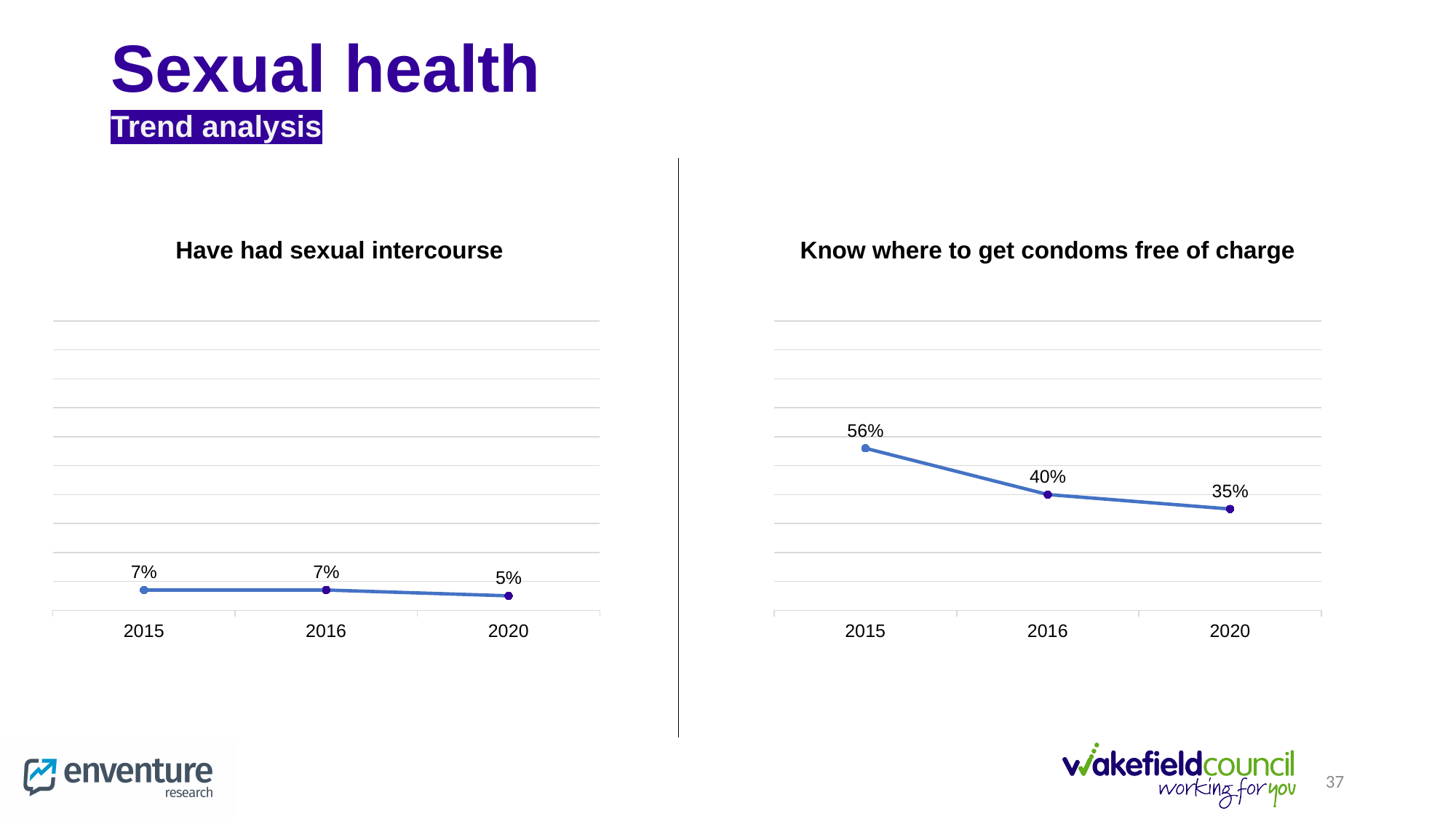
In the 'Know where to get condoms free of charge' chart, do the values rise or fall from 2015 to 2020? fall What type of chart is the 'Know where to get condoms free of charge' chart? line chart In the 'Know where to get condoms free of charge' chart, what is the difference between the 2015 and 2020 values? 21 percentage points In the 'Know where to get condoms free of charge' chart, which year has the lowest value? 2020 In the 'Have had sexual intercourse' chart, what is the value for 2015? 7% In the 'Know where to get condoms free of charge' chart, is the value for 2016 larger or smaller than the value for 2020? larger In the 'Have had sexual intercourse' chart, what is the difference between the 2016 and 2020 values? 2 percentage points In the 'Know where to get condoms free of charge' chart, what is the value for 2016? 40% In the 'Know where to get condoms free of charge' chart, what is the value for 2015? 56% In the 'Know where to get condoms free of charge' chart, which year has the highest value? 2015 In the 'Have had sexual intercourse' chart, what is the value for 2020? 5% How many data points are plotted in the 'Have had sexual intercourse' chart? 3